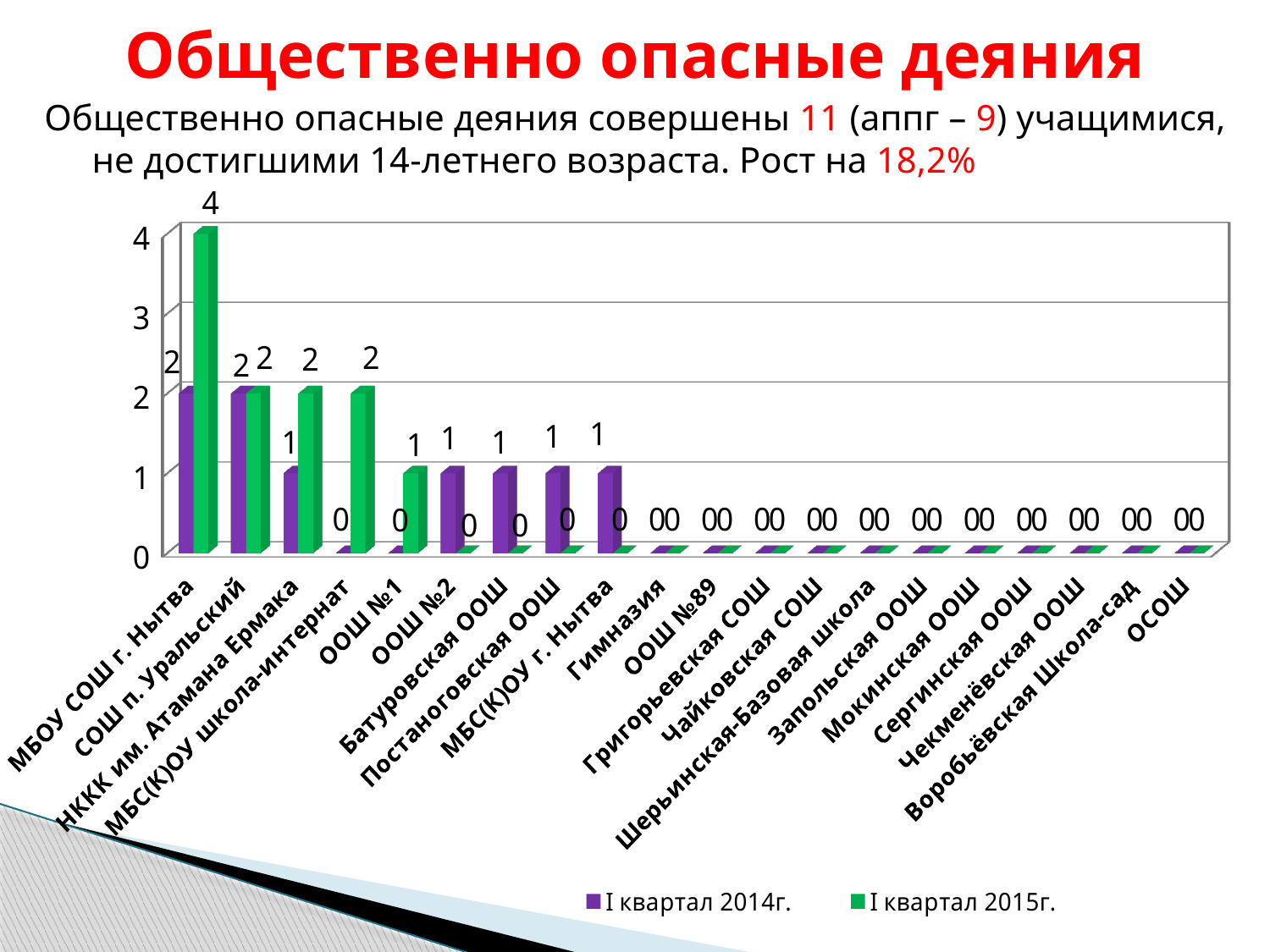
What is the value for МБС(К)ОУ школа-интернат in the I квартал 2015г. series? 2 What is the value for МБОУ СОШ г. Нытва in the I квартал 2015г. series? 4 How many series does the legend list? 2 What is the difference between the I квартал 2015г. and I квартал 2014г. values for МБОУ СОШ г. Нытва? 2 What is the value for ООШ №2 in the I квартал 2015г. series? 0 Which category has the highest value in the I квартал 2015г. series? МБОУ СОШ г. Нытва Which colour represents the I квартал 2014г. series in the chart? Purple What kind of chart is shown on the slide? Bar chart What is the value for МБОУ СОШ г. Нытва in the I квартал 2014г. series? 2 What is the value for НКККК им. Атамана Ермака in the I квартал 2014г. series? 1 How many categories are shown on the x axis of the chart? 20 For НКККК им. Атамана Ермака, which series has the larger value, I квартал 2014г. or I квартал 2015г.? I квартал 2015г.